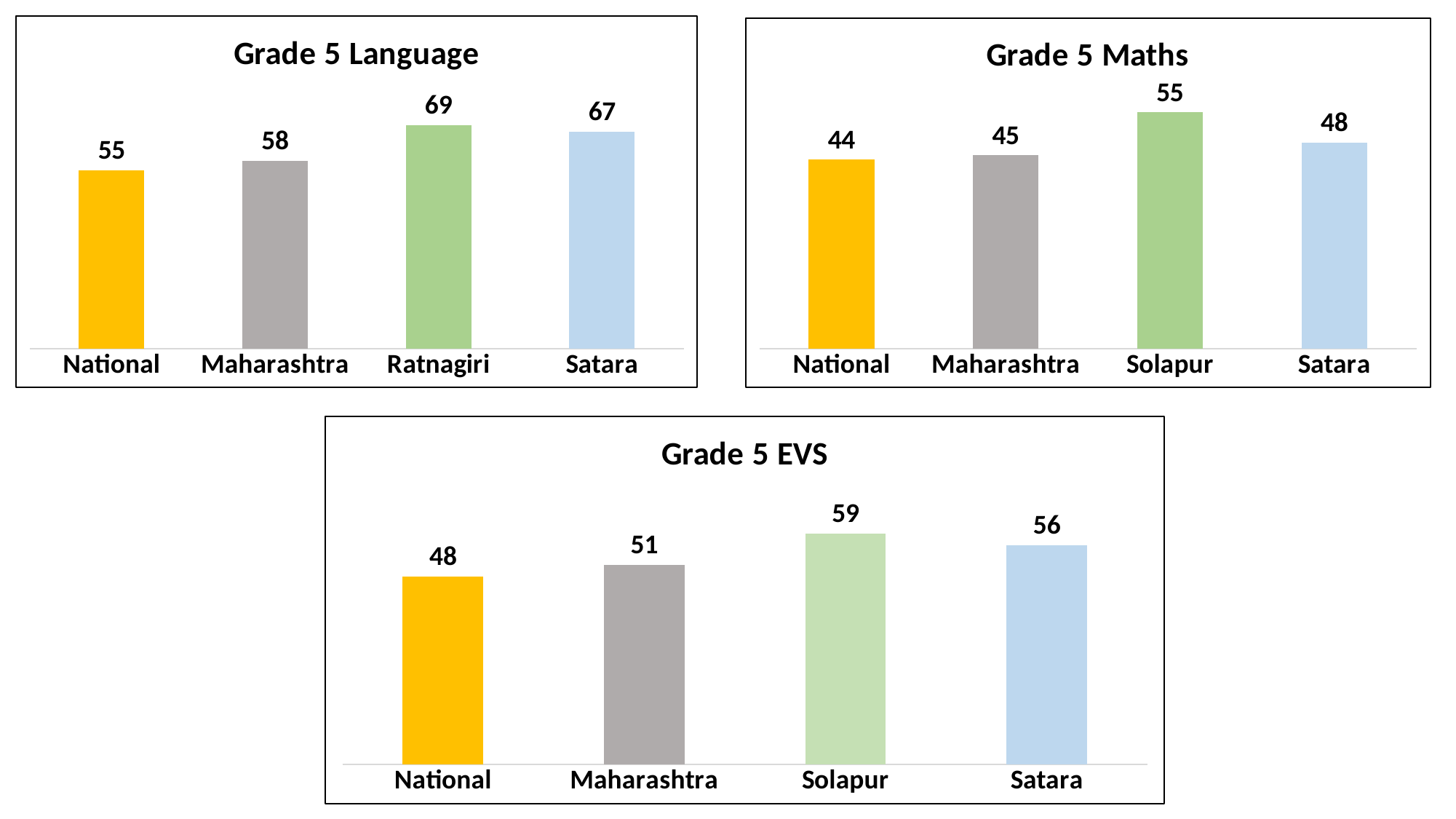
In the Grade 5 EVS chart, which category has the highest value? Solapur How many charts are shown on the slide? 3 How many categories are shown in the Grade 5 Maths chart? 4 In the Grade 5 Maths chart, what is the difference between the values for Solapur and Maharashtra? 10 In the Grade 5 Maths chart, what is the value for National? 44 In the Grade 5 Maths chart, which category has the lowest value? National In the Grade 5 Language chart, what is the value for Ratnagiri? 69 In the Grade 5 EVS chart, what is the value for Satara? 56 In the Grade 5 EVS chart, which is larger, the value for Maharashtra or the value for Satara? Satara What kind of chart is the Grade 5 EVS chart? Bar chart In the Grade 5 Language chart, which category has the highest value? Ratnagiri In the Grade 5 Language chart, what is the difference between the values for Satara and National? 12